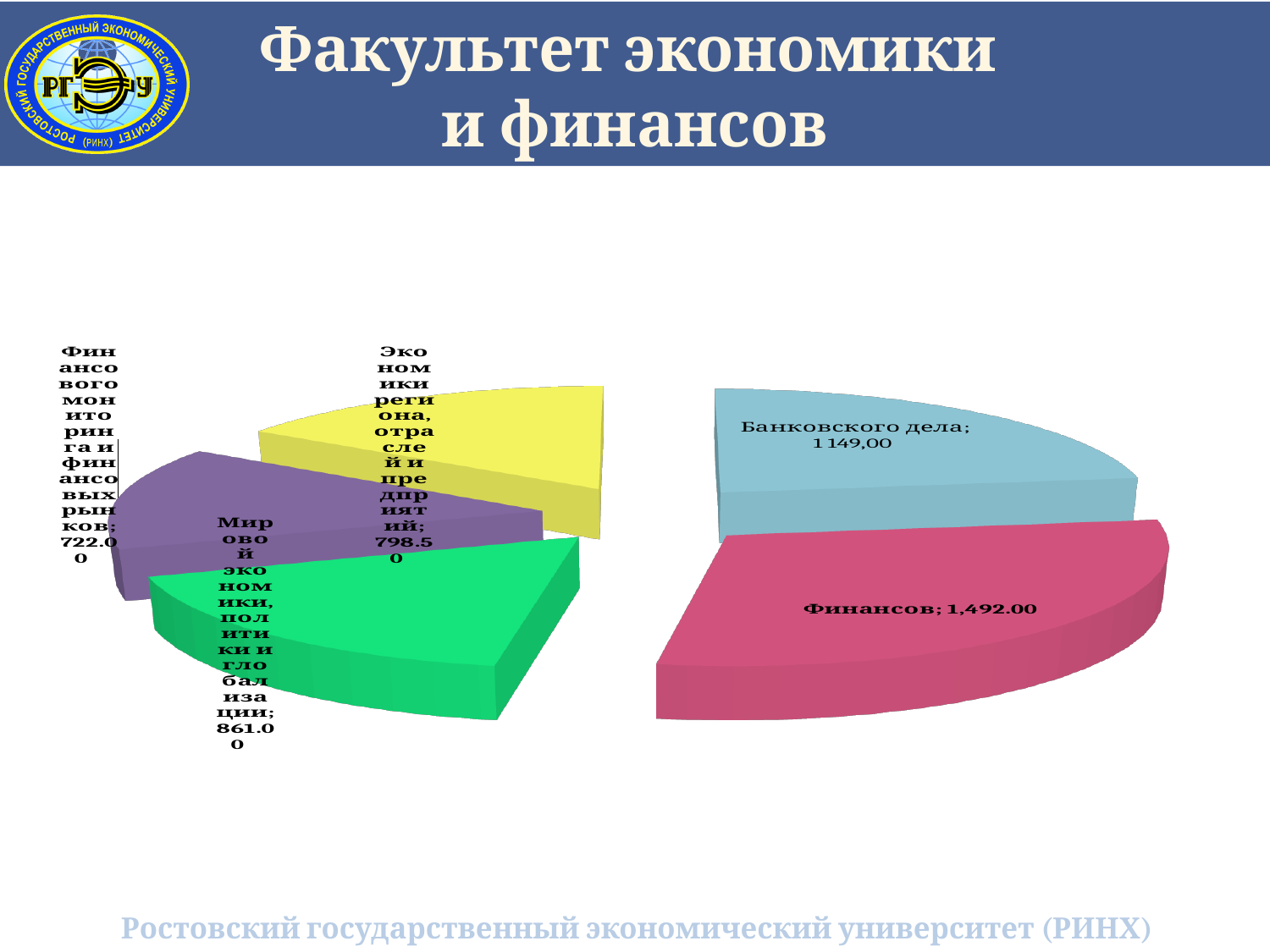
What is the value shown for the Банковского дела slice? 1 149,00 What is the value shown for the Финансов slice? 1,492.00 Which slice has the smallest value? Финансового мониторинга и финансовых рынков Which slice has the largest value? Финансов What colour is the Финансов slice? Pink Which is larger: the value for Мировой экономики, политики и глобализации or the value for Экономики региона, отраслей и предприятий? Мировой экономики, политики и глобализации What is the value shown for the Экономики региона, отраслей и предприятий slice? 798.50 How many slices does the pie chart have? 5 What is the difference between the Финансов value and the Банковского дела value? 343.00 What is the value shown for the Мировой экономики, политики и глобализации slice? 861.00 What kind of chart is shown on the slide? Pie chart What is the value shown for the Финансового мониторинга и финансовых рынков slice? 722.00